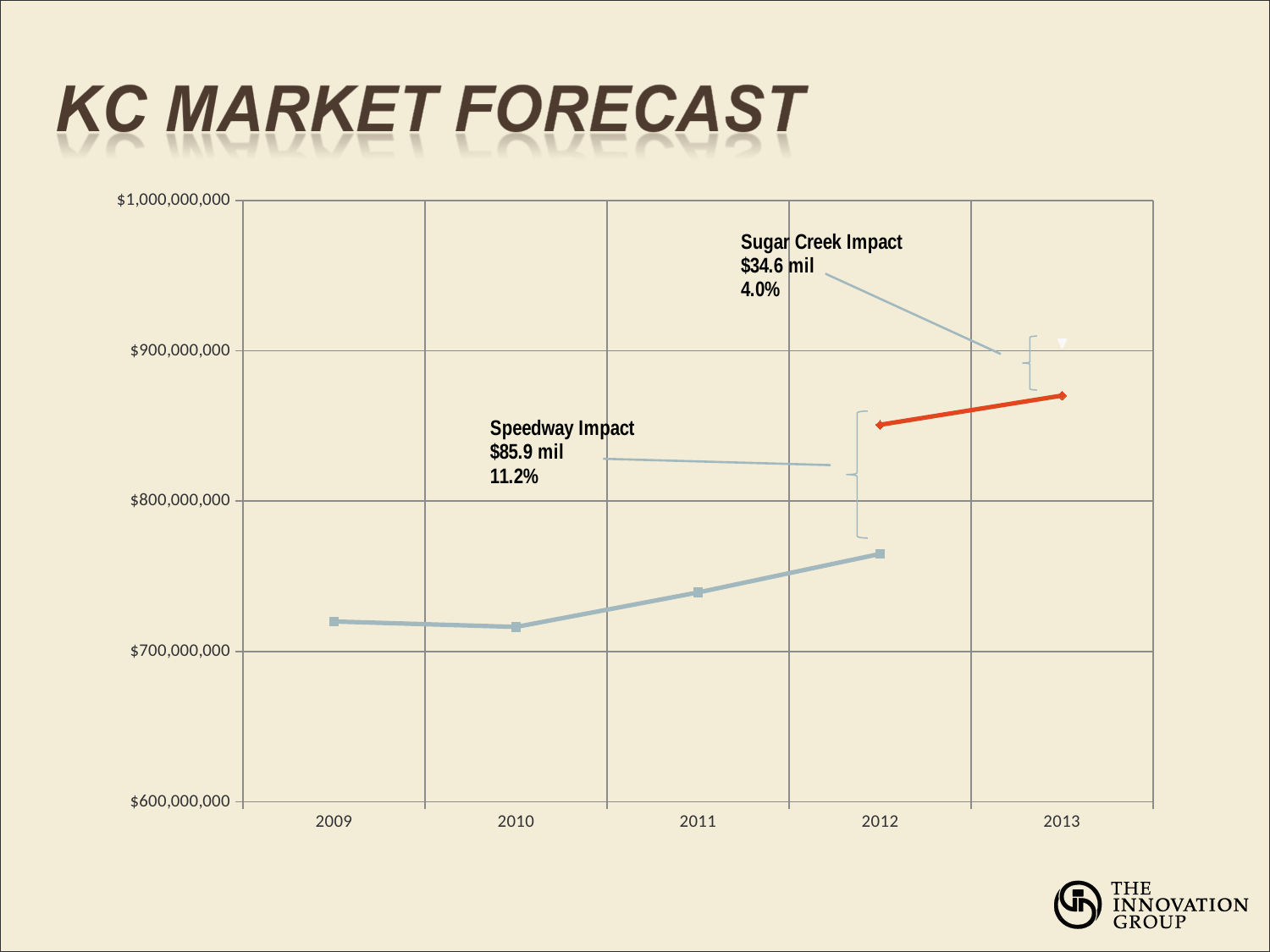
How many years are shown on the x axis of the chart? 5 Which annotated impact is larger, Speedway Impact or Sugar Creek Impact? Speedway Impact What percentage is given for the Speedway Impact on the chart? 11.2% What percentage is given for the Sugar Creek Impact on the chart? 4.0% What is the dollar value of the Sugar Creek Impact annotated on the chart? $34.6 mil Is the value plotted for 2012 on the blue line greater or less than $800,000,000? less Does the blue line rise or fall from 2010 to 2012? rise Is the value plotted for 2013 on the red line greater or less than $900,000,000? less What is the title of the slide containing the chart? KC Market Forecast What is the difference in millions between the Speedway Impact and the Sugar Creek Impact? $51.3 mil What kind of chart is shown on the slide? line chart What is the dollar value of the Speedway Impact annotated on the chart? $85.9 mil